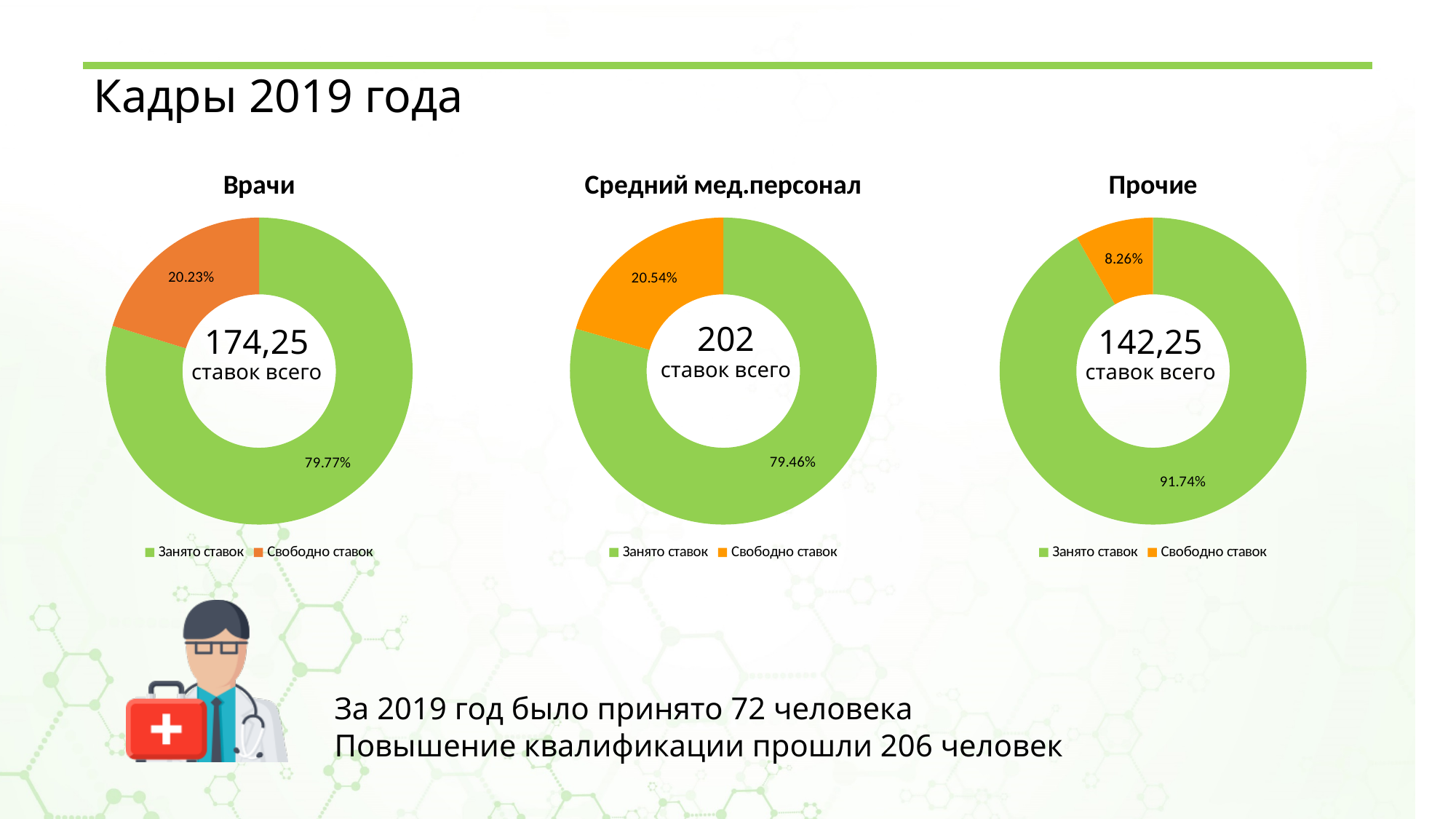
What total number of positions (ставок всего) is shown in the centre of the "Врачи" chart? 174,25 In the "Прочие" chart, what percentage is shown for "Свободно ставок"? 8.26% In the "Врачи" chart, what percentage is shown for "Занято ставок"? 79.77% In the "Врачи" chart, what percentage is shown for "Свободно ставок"? 20.23% In the "Прочие" chart, which slice is larger, "Занято ставок" or "Свободно ставок"? Занято ставок In the "Средний мед.персонал" chart, what percentage is shown for "Свободно ставок"? 20.54% In the "Прочие" chart, what percentage is shown for "Занято ставок"? 91.74% What total number of positions (ставок всего) is shown in the centre of the "Средний мед.персонал" chart? 202 How many series does the legend of the "Прочие" chart list? 2 What type of chart is used for "Врачи"? Doughnut (pie) chart What is the difference between the "Занято ставок" and "Свободно ставок" percentages in the "Средний мед.персонал" chart? 58.92% In the "Средний мед.персонал" chart, which slice is the smallest? Свободно ставок